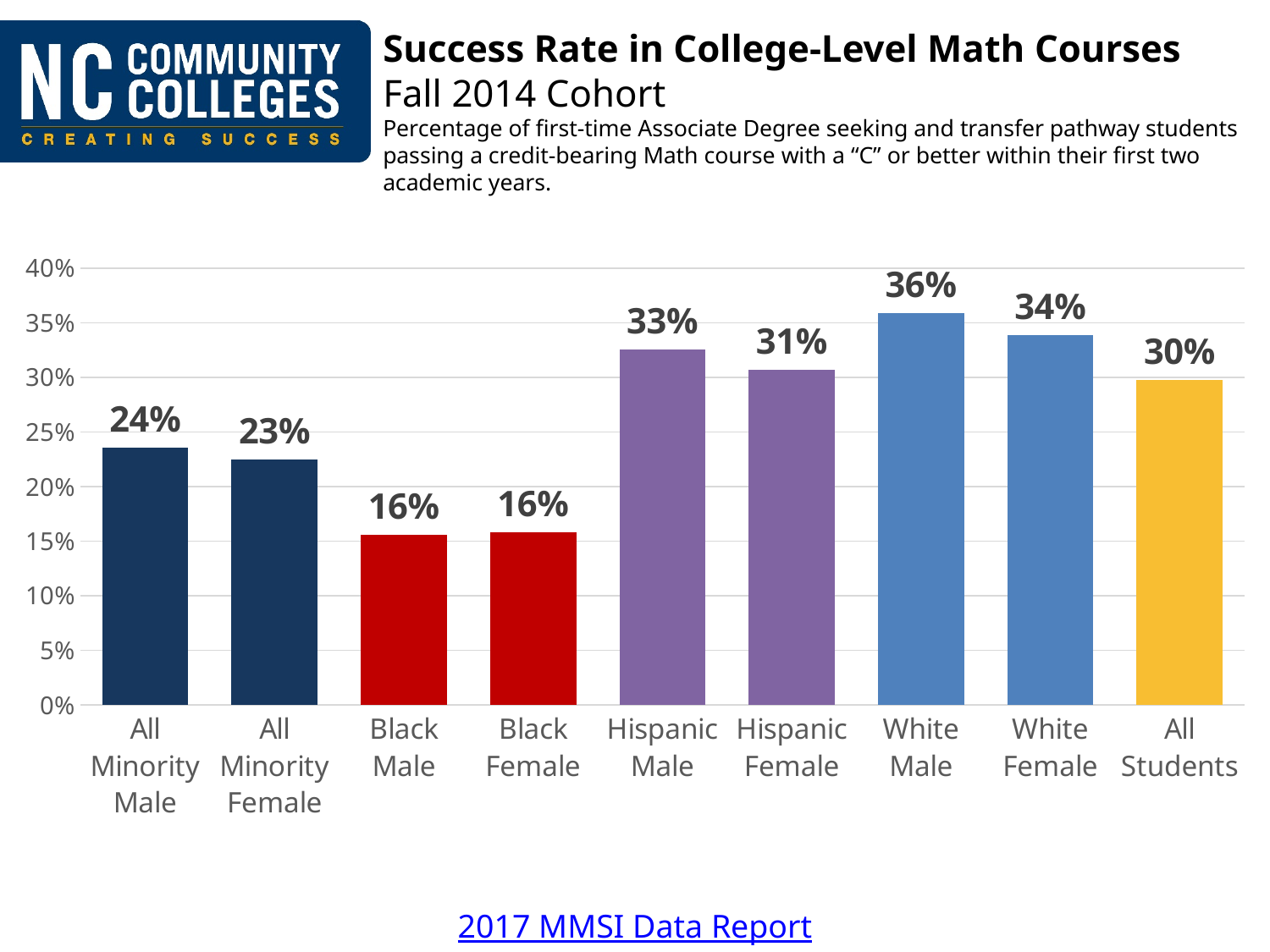
What is the title of the chart? Success Rate in College-Level Math Courses What colour are the bars for Black Male and Black Female? Red What is the difference in success rate between Hispanic Male and Hispanic Female students? 2% Is the value for All Minority Male greater or less than 20%? greater What is the success rate for White Male students? 36% What is the success rate for All Minority Female students? 23% What is the difference in success rate between White Male and Black Male students? 20% Which is larger, the success rate for White Female or for All Students? White Female What is the success rate for All Students? 30% How many categories are shown on the x axis? 9 What kind of chart is shown on the slide? Bar chart Which category has the highest success rate? White Male